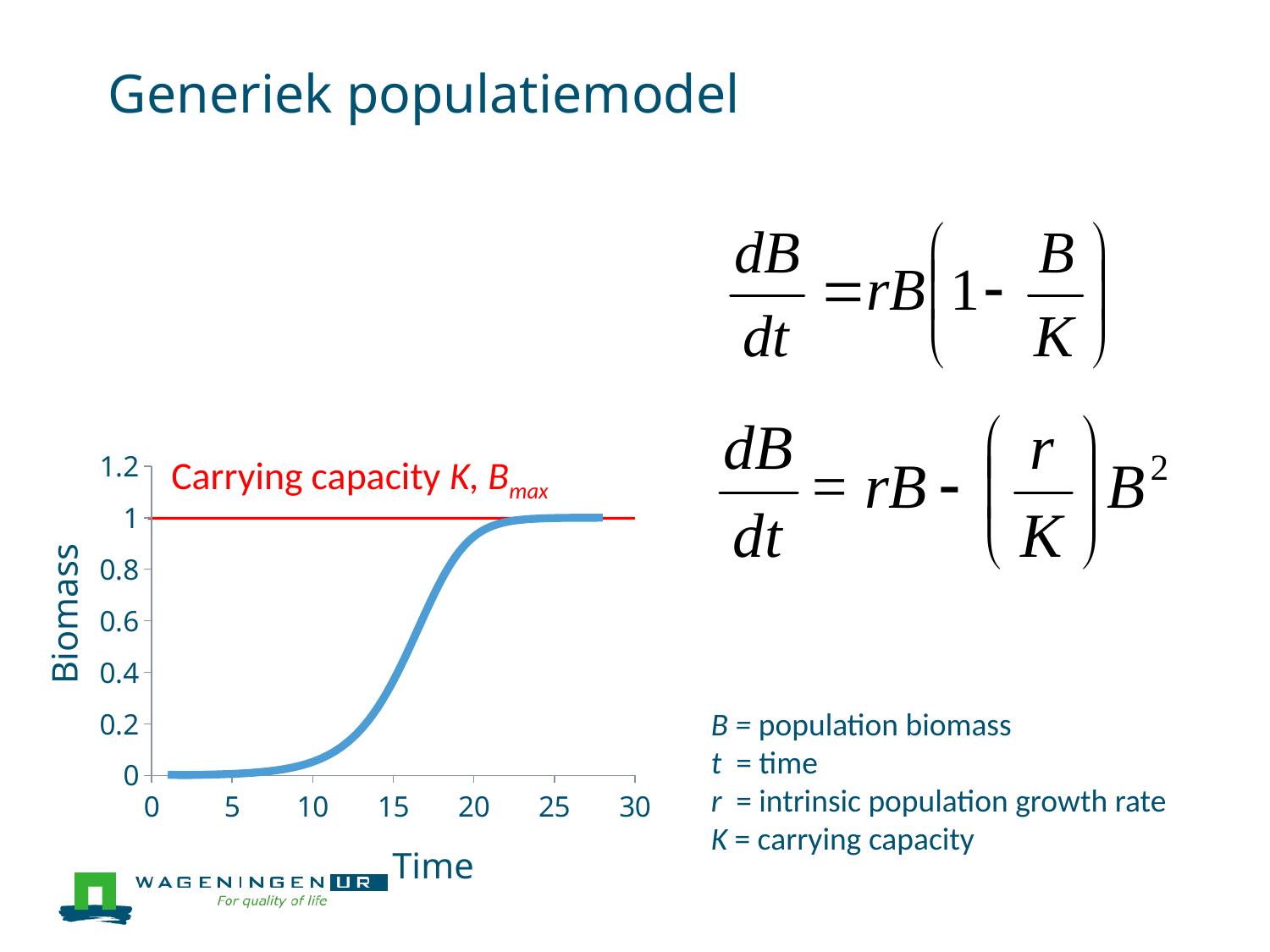
What kind of chart is shown on the slide? line chart At what Biomass value is the red horizontal line labelled 'Carrying capacity K, Bmax' drawn? 1 Is the biomass value at time 25 greater or less than 0.8? greater Is the biomass value at time 15 greater or less than 0.6? less What is the label of the y axis of the chart? Biomass Is the biomass value at time 5 greater or less than 0.2? less Does the biomass curve rise or fall as time increases along the x axis? rise What is the highest tick value shown on the Biomass axis? 1.2 Is the biomass at time 15 greater or less than the biomass at time 20? less What is the label of the x axis of the chart? Time